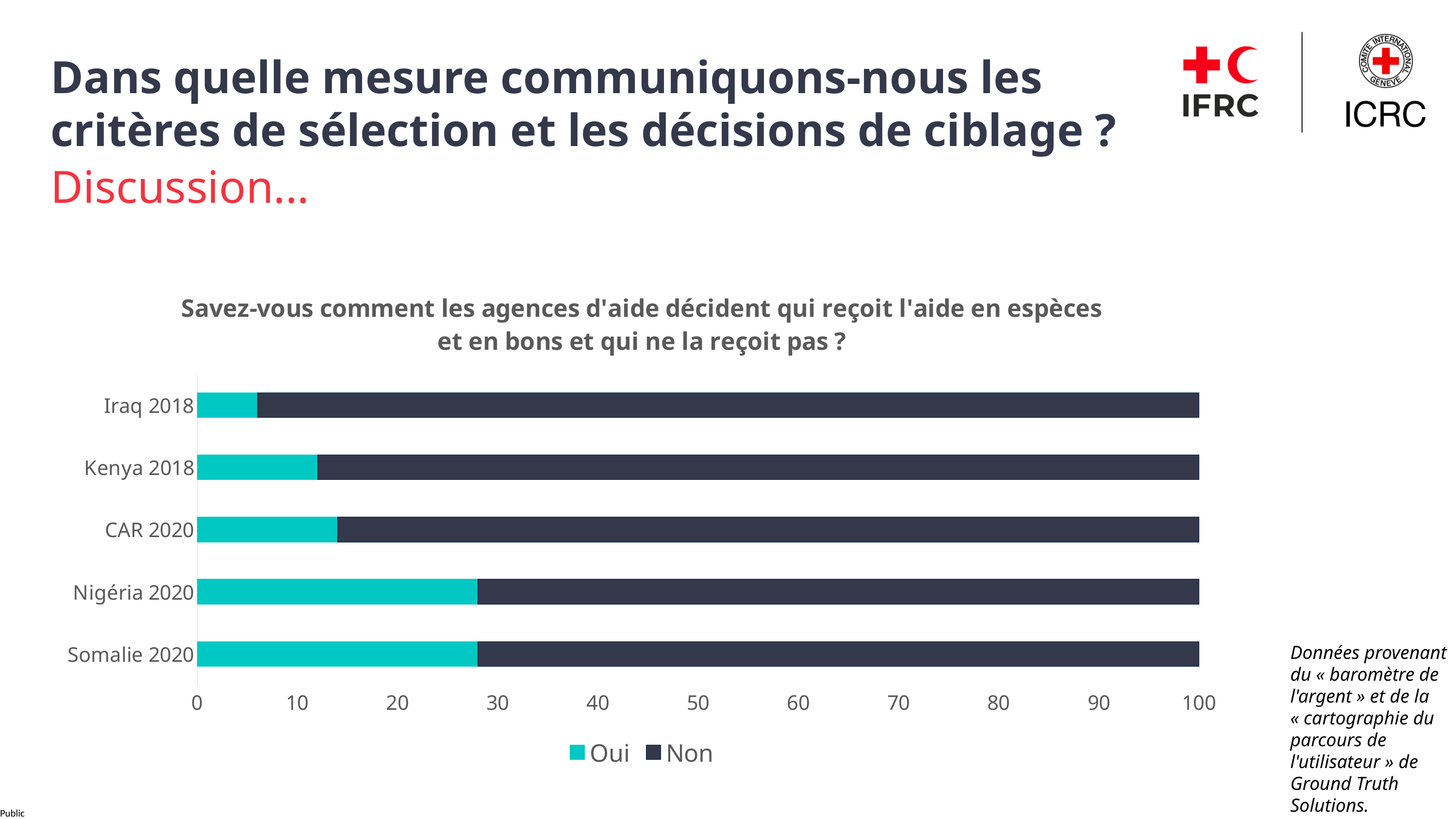
Which category has the largest Non value? Iraq 2018 What kind of chart is shown on the slide? bar chart Is the Non value for Iraq 2018 greater or less than 90? greater What is the total of the stacked bar for Kenya 2018? 100 How many series does the legend list? 2 Which has the larger Oui value, CAR 2020 or Nigéria 2020? Nigéria 2020 Is the Oui value for Nigéria 2020 greater or less than 20? greater What are the two series named in the legend? Oui and Non Which category has the smallest Oui value? Iraq 2018 How many categories are shown on the chart? 5 Is the Oui value for Iraq 2018 greater or less than 10? less